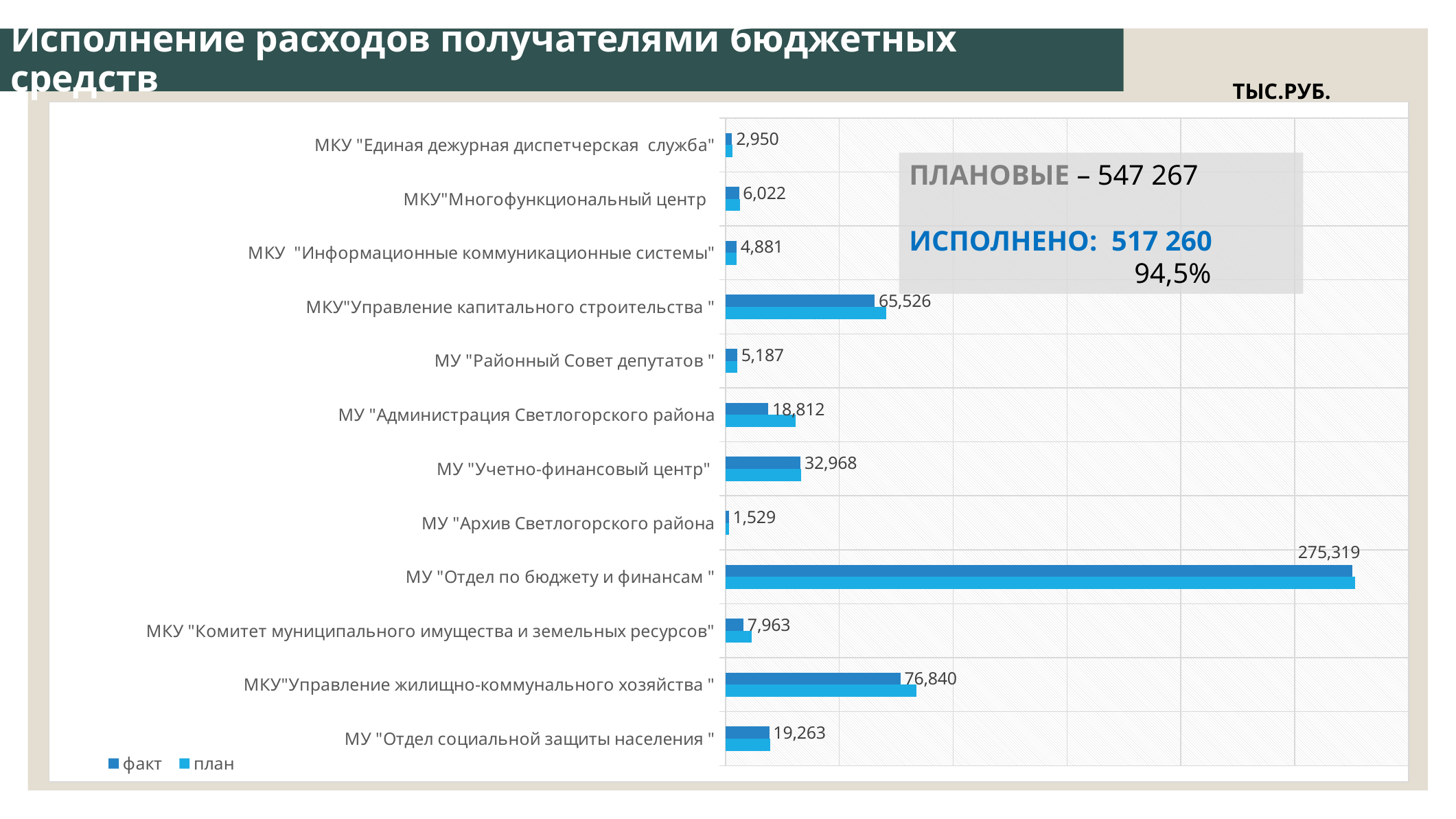
How many series does the chart legend list? 2 How many categories (budget recipients) are shown on the chart? 12 What is the факт value labelled for МУ "Отдел по бюджету и финансам"? 275,319 Which category has the highest факт value? МУ "Отдел по бюджету и финансам" Which category has the lowest факт value? МУ "Архив Светлогорского района" What is the факт value labelled for МКУ "Управление жилищно-коммунального хозяйства"? 76,840 What is the difference between the факт values for МКУ "Управление жилищно-коммунального хозяйства" and МКУ "Управление капитального строительства"? 11,314 What is the факт value labelled for МУ "Архив Светлогорского района"? 1,529 What is the факт value labelled for МУ "Учетно-финансовый центр"? 32,968 What type of chart is shown on the slide? bar chart What are the two legend entries of the chart? факт, план Which has the larger факт value: МУ "Администрация Светлогорского района" or МУ "Отдел социальной защиты населения"? МУ "Отдел социальной защиты населения"